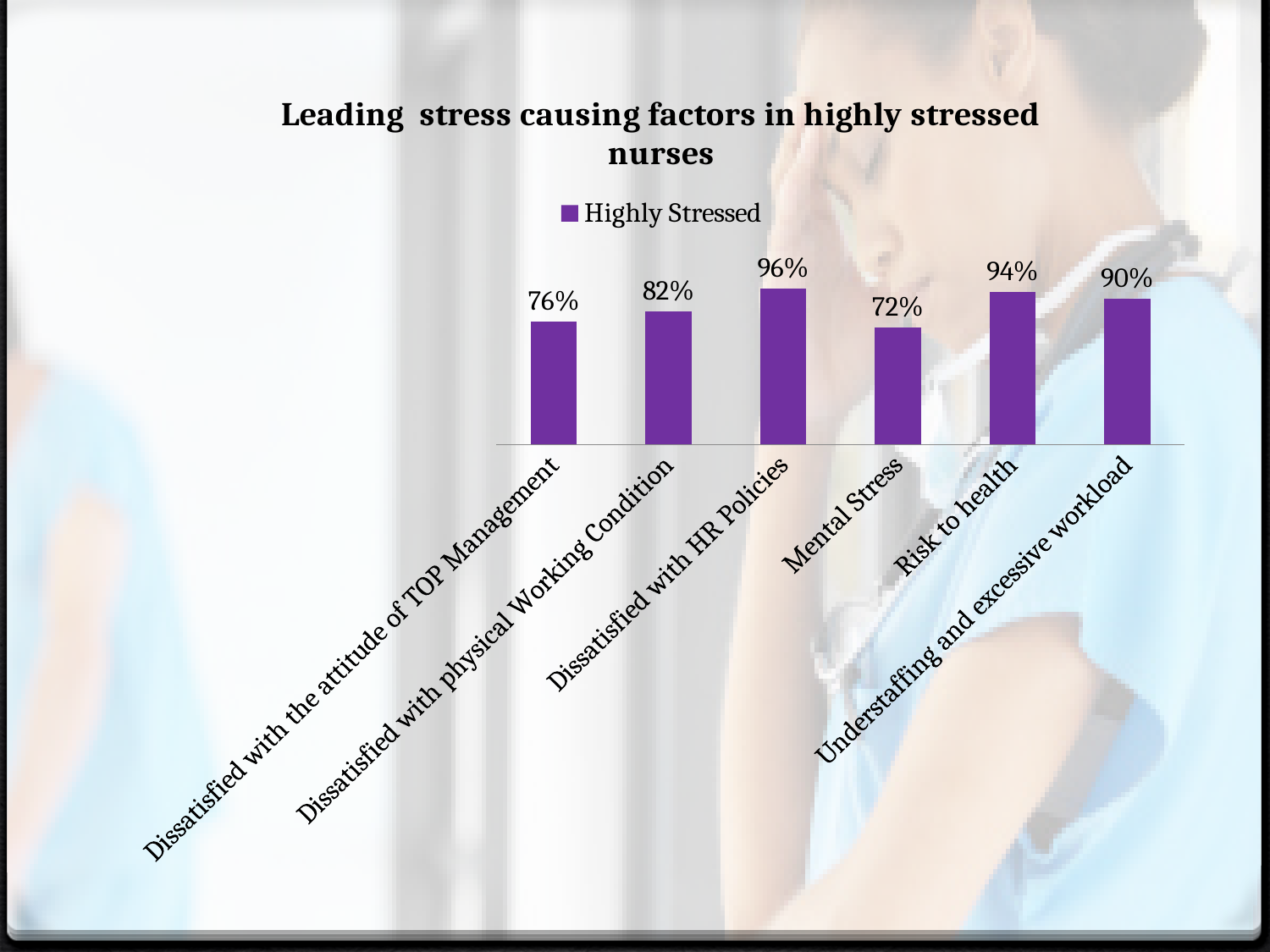
Which category has the lowest value? Mental Stress How many categories are shown in the chart? 6 Which is larger, the value for Risk to health or the value for Understaffing and excessive workload? Risk to health What is the name of the series shown in the legend? Highly Stressed How many series does the legend list? 1 What is the value for Mental Stress? 72% What kind of chart is shown on the slide? Bar chart What is the value for Dissatisfied with HR Policies? 96% What is the value for Understaffing and excessive workload? 90% What is the difference between the values for Risk to health and Dissatisfied with the attitude of TOP Management? 18% What is the value for Dissatisfied with physical Working Condition? 82% Which category has the highest value? Dissatisfied with HR Policies